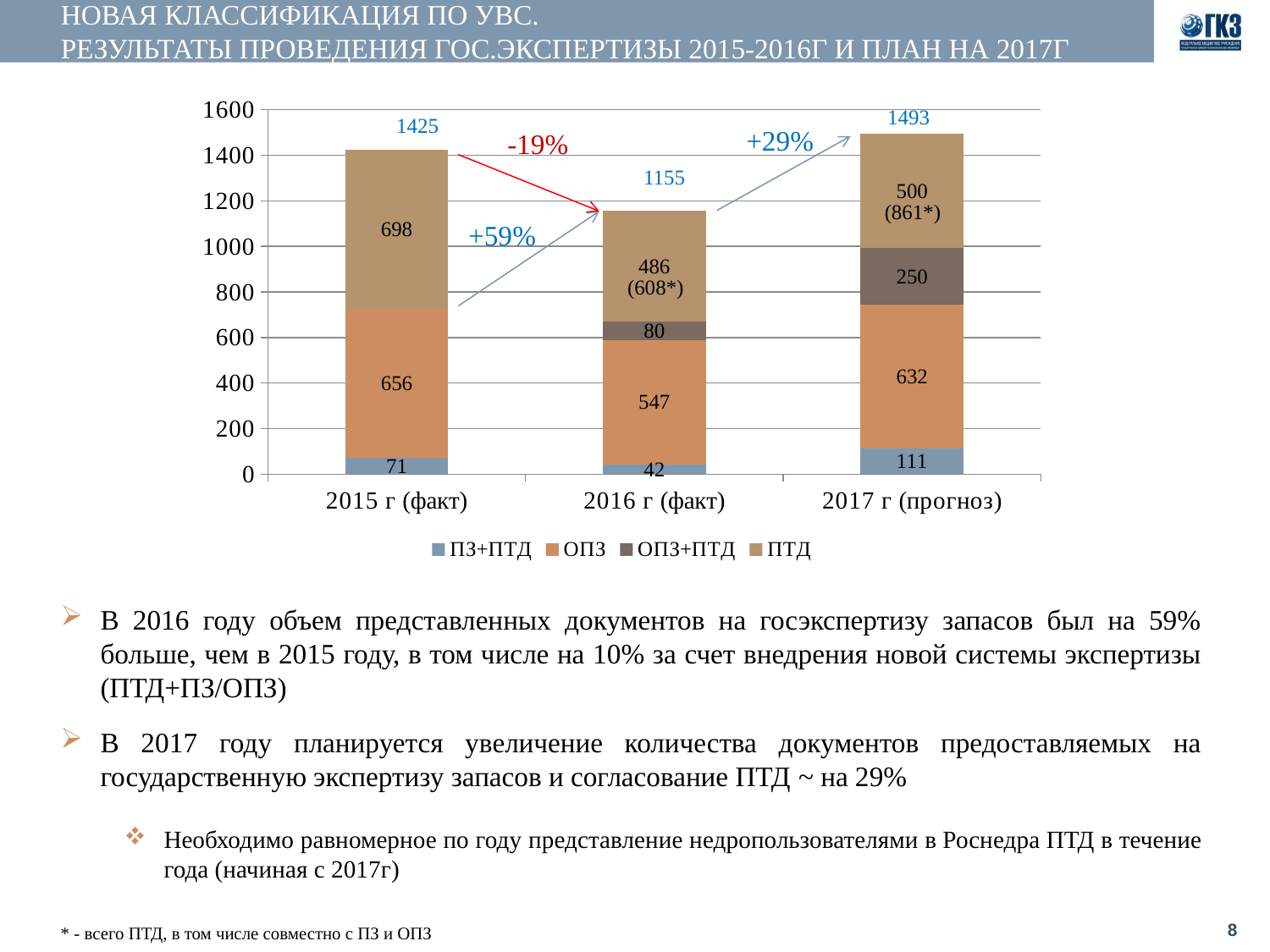
What is the total of the stacked bar for 2016 г (факт)? 1155 What is the value of ОПЗ for 2016 г (факт)? 547 Which category has the lowest stacked bar total? 2016 г (факт) What kind of chart is shown on the slide? stacked bar chart How many categories are shown on the x axis? 3 Which is larger, the ПЗ+ПТД value for 2015 г (факт) or for 2016 г (факт)? 2015 г (факт) Which category has the highest stacked bar total? 2017 г (прогноз) What is the difference between the ОПЗ values for 2015 г (факт) and 2016 г (факт)? 109 How many series does the legend list? 4 What is the value of ПЗ+ПТД for 2017 г (прогноз)? 111 What is the value of ОПЗ+ПТД for 2017 г (прогноз)? 250 What is the value of ПТД for 2015 г (факт)? 698